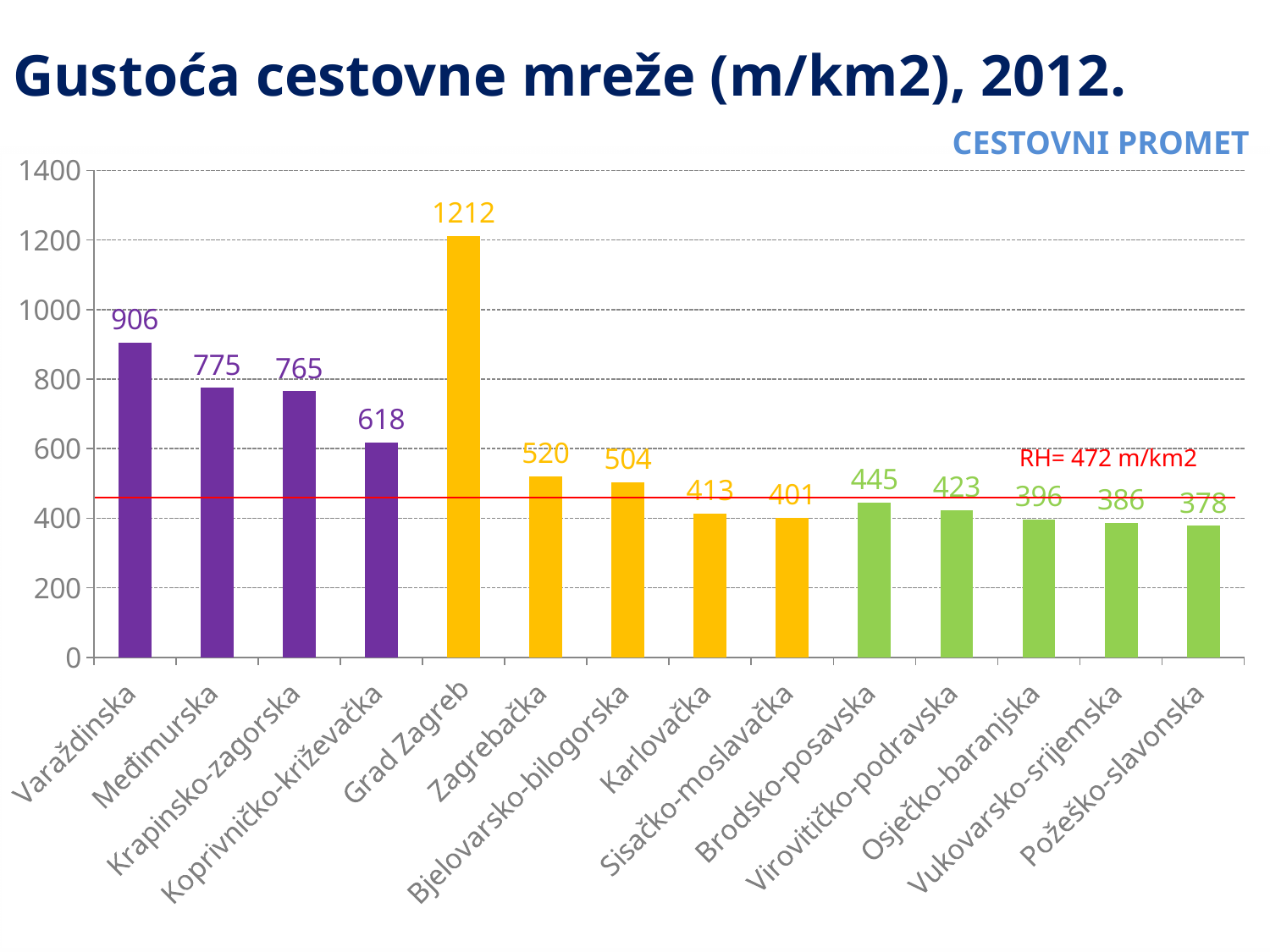
What is the difference between the values for Grad Zagreb and Zagrebačka? 692 What value does the red horizontal reference line (RH) represent? 472 m/km2 How many categories are shown on the x axis? 14 What kind of chart is shown on the slide? Bar chart Which is larger, the value for Koprivničko-križevačka or the value for Zagrebačka? Koprivničko-križevačka Which category has the lowest value? Požeško-slavonska What is the value shown for Sisačko-moslavačka? 401 What is the value shown for Varaždinska? 906 What is the difference between the values for Varaždinska and Međimurska? 131 What is the title of the chart? Gustoća cestovne mreže (m/km2), 2012. What is the road network density value for Grad Zagreb? 1212 Which category has the highest value? Grad Zagreb